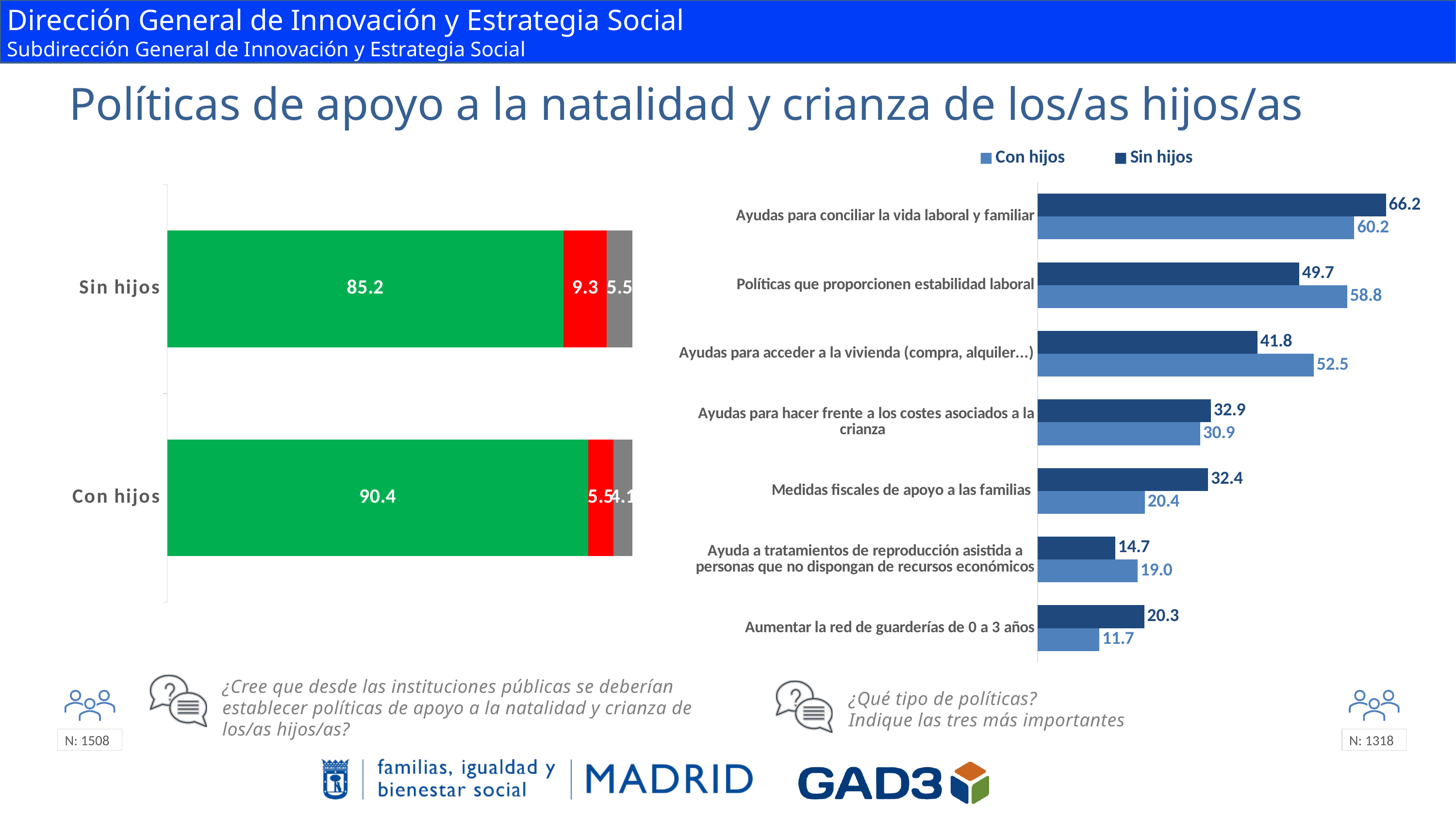
How many series does the legend of the chart on the right list? 2 In the chart on the right, what is the difference between the 'Con hijos' and 'Sin hijos' values for 'Ayudas para acceder a la vivienda (compra, alquiler…)'? 10.7 In the chart on the right, what is the value for 'Sin hijos' for 'Ayudas para conciliar la vida laboral y familiar'? 66.2 How many policies are listed in the chart on the right? 7 In the chart on the right, what is the value for 'Con hijos' for 'Políticas que proporcionen estabilidad laboral'? 58.8 In the chart on the right, which policy has the lowest value for 'Sin hijos'? Ayuda a tratamientos de reproducción asistida a personas que no dispongan de recursos económicos In the chart on the left, what is the value of the red segment for 'Sin hijos'? 9.3 In the chart on the right, for 'Medidas fiscales de apoyo a las familias', which is larger: 'Con hijos' or 'Sin hijos'? Sin hijos In the chart on the left, what is the value of the green segment for 'Con hijos'? 90.4 In the chart on the right, which policy has the highest value for 'Con hijos'? Ayudas para conciliar la vida laboral y familiar What kind of chart is the chart on the left? Stacked bar chart In the chart on the left, what is the total of the 'Sin hijos' bar? 100.0